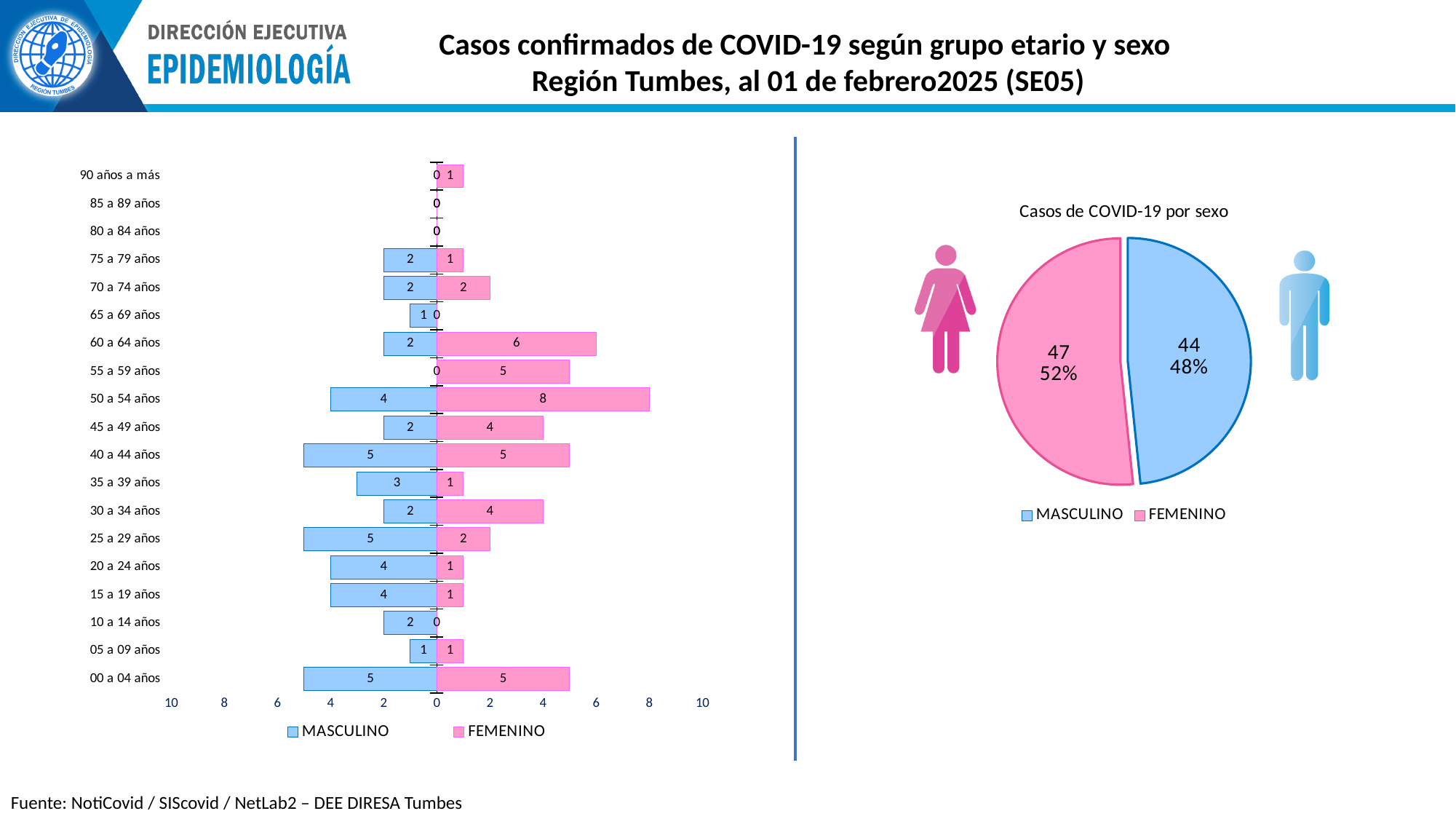
In the left chart (cases by age group and sex), how many FEMENINO cases are in the 50 a 54 años group? 8 In the left chart (cases by age group and sex), how many MASCULINO cases are in the 40 a 44 años group? 5 In the left chart (cases by age group and sex), what is the difference between the FEMENINO and MASCULINO values for 60 a 64 años? 4 In the left chart (cases by age group and sex), which age group has the highest FEMENINO value? 50 a 54 años In the pie chart 'Casos de COVID-19 por sexo', which colour represents FEMENINO? Pink In the left chart (cases by age group and sex), how many age groups are shown? 19 In the pie chart 'Casos de COVID-19 por sexo', what is the total number of cases across both slices? 91 In the left chart (cases by age group and sex), which is larger for 25 a 29 años, MASCULINO or FEMENINO? MASCULINO In the pie chart 'Casos de COVID-19 por sexo', what is the value for MASCULINO? 44 In the left chart (cases by age group and sex), how many series does the legend list? 2 What kind of chart is the left chart showing cases by age group and sex? Bar chart In the pie chart 'Casos de COVID-19 por sexo', what share of cases is FEMENINO? 52%